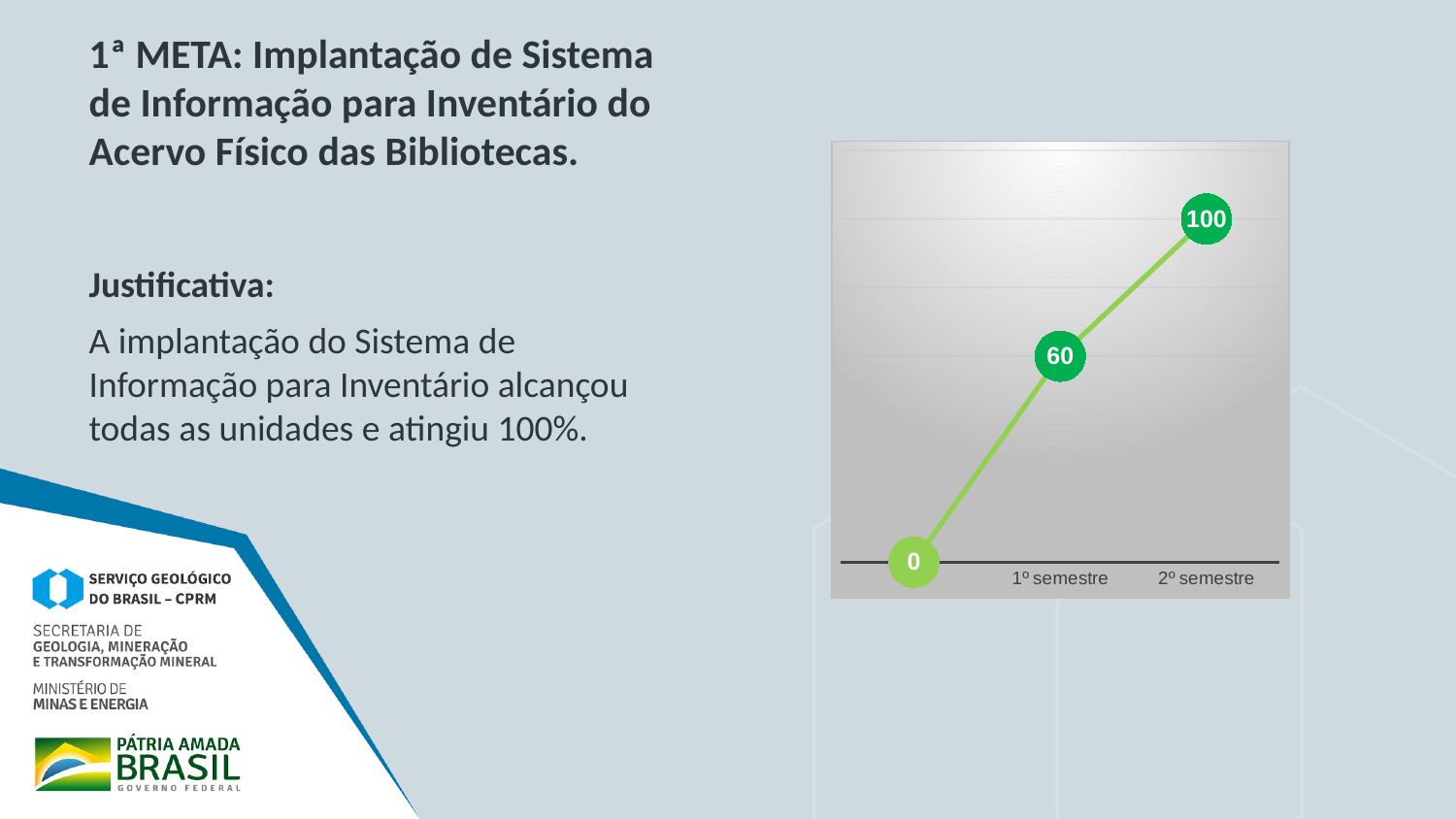
What colour is the line in the chart? green Which labelled semester has the lower value? 1º semestre How many data points are plotted on the line? 3 What is the difference between the value for 1º semestre and the first point of the line? 60 What is the value plotted for 2º semestre? 100 What kind of chart is shown on the slide? line chart What is the value plotted for 1º semestre? 60 Which labelled semester has the higher value? 2º semestre Is the value for 2º semestre larger or smaller than the value for 1º semestre? larger What is the difference between the values for 2º semestre and 1º semestre? 40 Do the values rise or fall from left to right along the x axis? rise What is the value of the first (leftmost) point on the line? 0